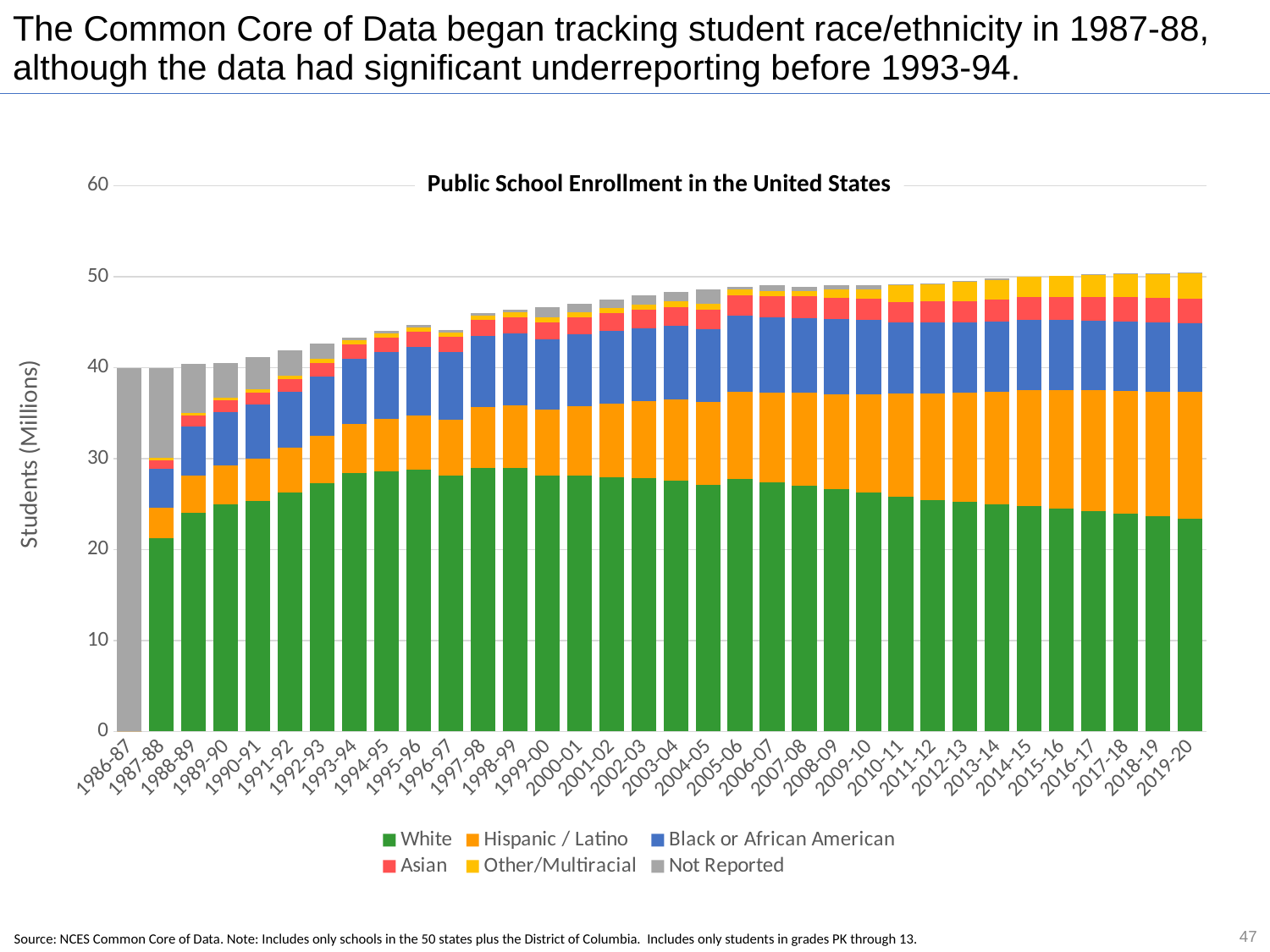
Is the White segment for 1987-88 greater or less than 20 million students? greater What is the label on the vertical axis? Students (Millions) Is the White segment for 2019-20 greater or less than 30 million students? less How many school years are shown along the x axis? 34 How many series does the legend list? 6 Is the total enrollment bar for 1986-87 greater or less than 50 million students? less What kind of chart is shown on the slide? Stacked bar chart From 2005-06 to 2019-20, does the White segment rise or fall? Fall In 2019-20, which segment is larger: White or Hispanic / Latino? White Which year has the larger Not Reported segment: 1986-87 or 1987-88? 1986-87 What is the title of the chart? Public School Enrollment in the United States